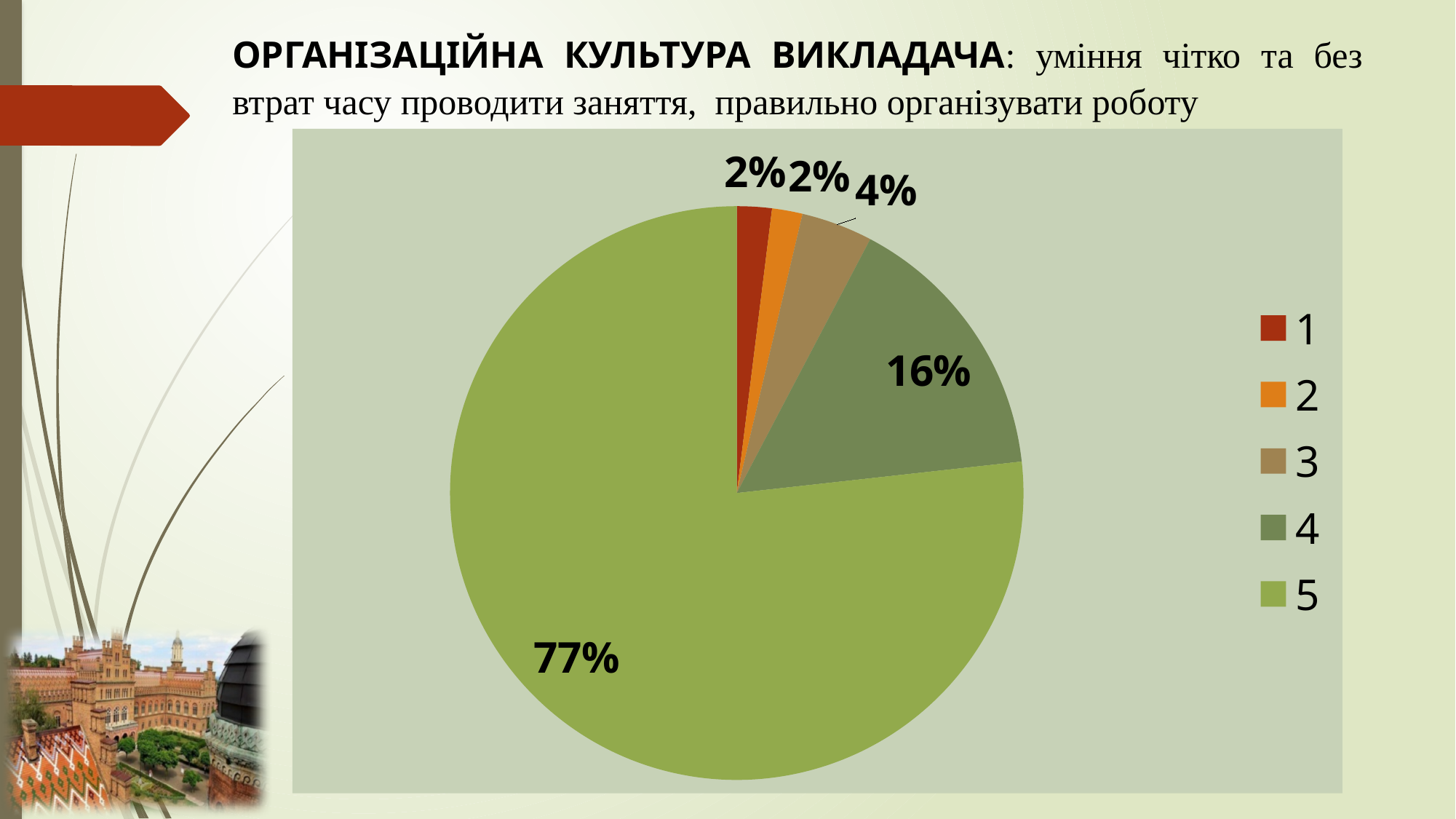
How many categories does the legend list? 5 Which category has the largest slice of the pie? 5 What share of the pie does category 5 have? 77% What kind of chart is shown on the slide? pie chart What share of the pie does category 4 have? 16% What is the combined share of categories 1, 2 and 3? 8% What colour is the slice for category 5? green Which is larger, the slice for category 4 or the slice for category 3? 4 Which legend entry is shown in dark red? 1 What share of the pie does category 1 have? 2% What share of the pie does category 3 have? 4% What is the difference in percentage points between category 5 and category 4? 61